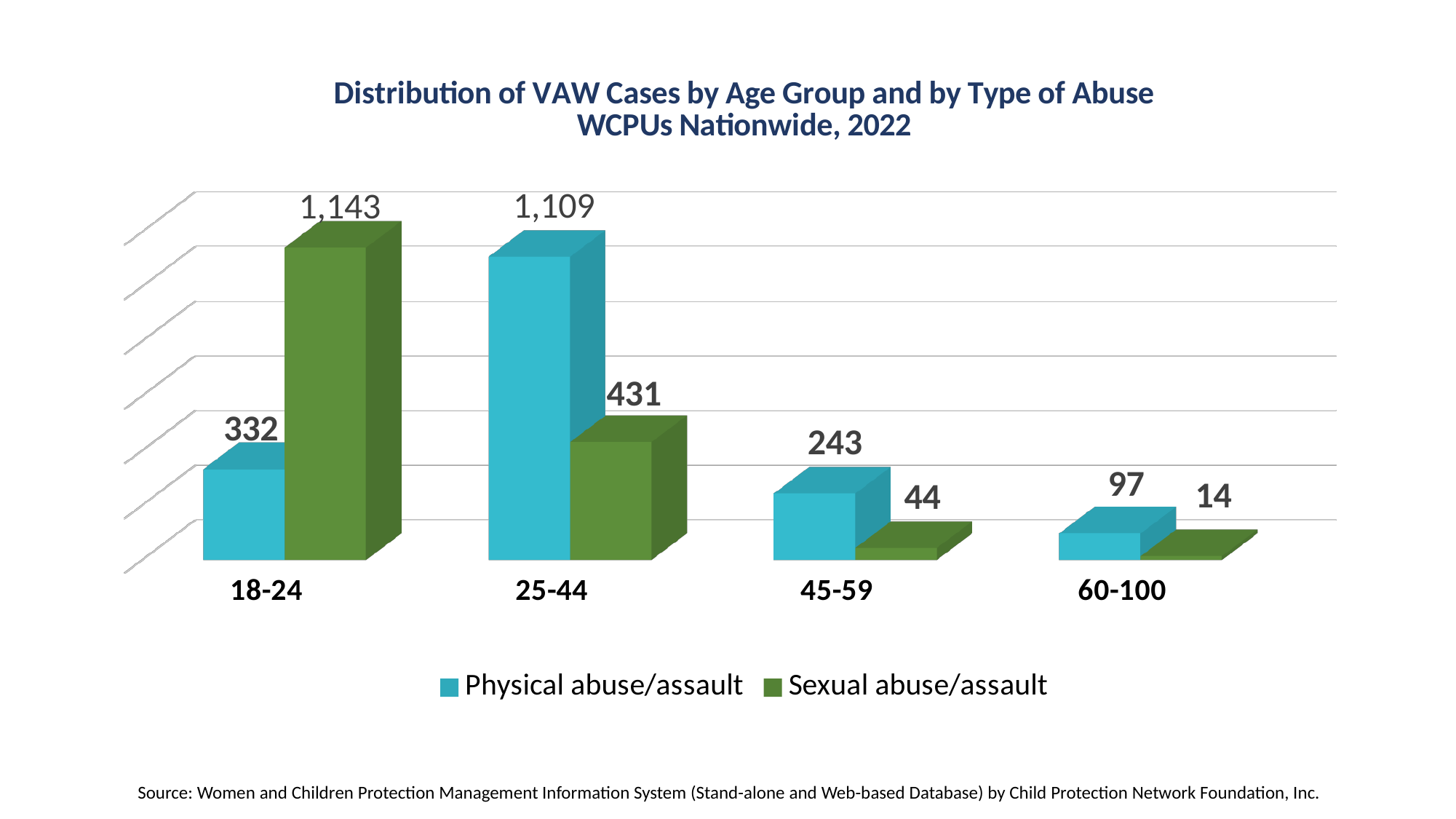
What kind of chart is shown on the slide? Bar chart What is the value for Sexual abuse/assault in the 18-24 age group? 1,143 Which age group has the highest value for Physical abuse/assault? 25-44 Which colour represents Sexual abuse/assault in the chart? Green How many series does the legend list? 2 Which is larger in the 45-59 age group: Physical abuse/assault or Sexual abuse/assault? Physical abuse/assault What is the difference between Sexual abuse/assault and Physical abuse/assault in the 18-24 age group? 811 What is the value for Physical abuse/assault in the 18-24 age group? 332 What is the value for Physical abuse/assault in the 25-44 age group? 1,109 Which age group has the lowest value for Sexual abuse/assault? 60-100 What is the value for Sexual abuse/assault in the 60-100 age group? 14 How many age groups are shown on the x axis? 4